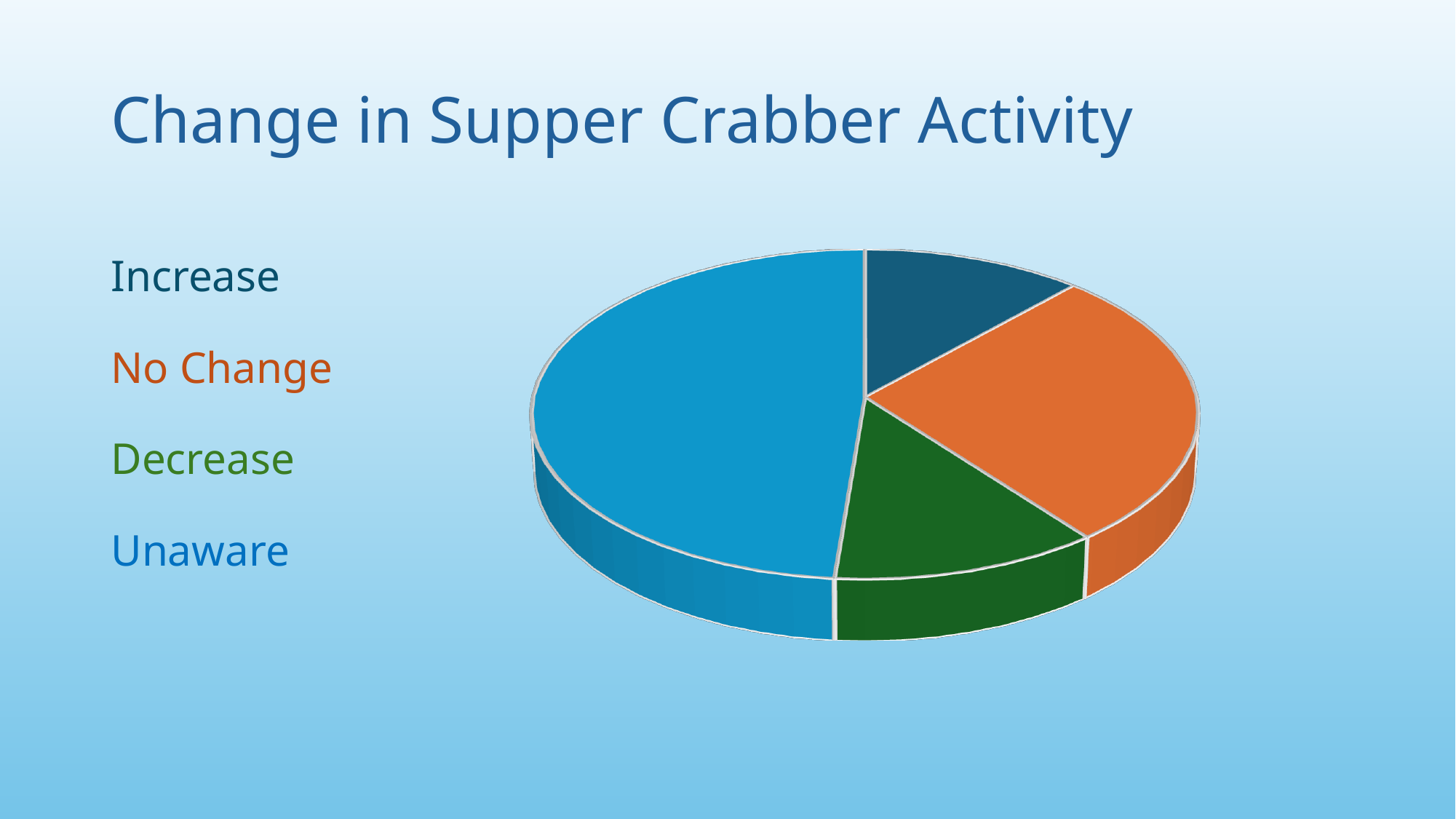
Which category is shown in orange on the pie chart? No Change Which slice is larger, Unaware or No Change? Unaware Which slice is larger, No Change or Decrease? No Change What kind of chart is shown on the slide? pie chart What is the title of the chart? Change in Supper Crabber Activity How many categories does the pie chart have? 4 Which category is listed first in the legend? Increase Which category has the largest slice of the pie? Unaware